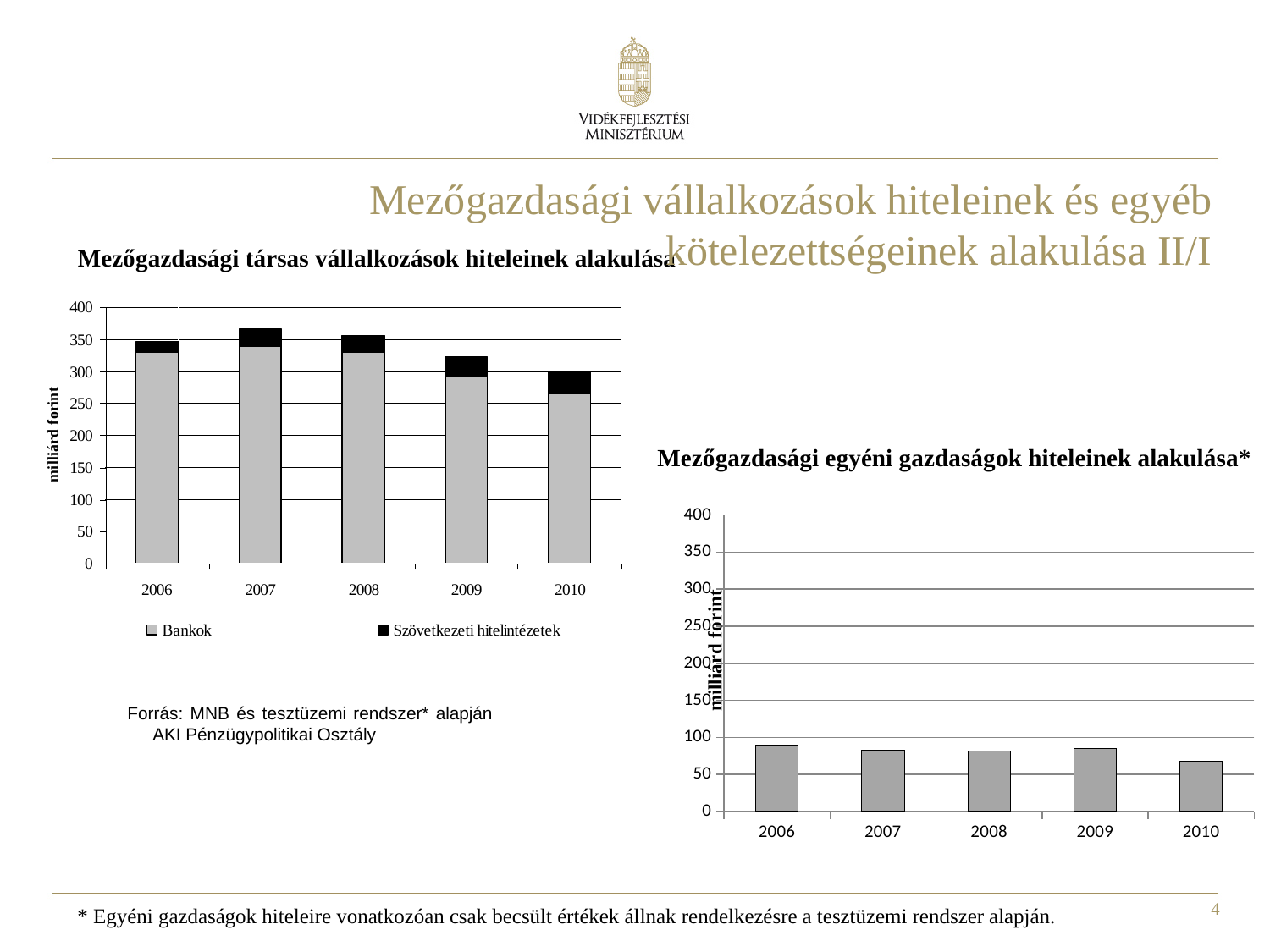
In the left chart, which year has the lowest total bar? 2010 How many series does the legend of the left chart list? 2 In the right chart, which year has the lowest bar? 2010 In the left chart, is the total for 2009 greater or less than 300? greater In the right chart, is the value for 2006 greater or less than 100? less What kind of chart is the right chart titled 'Mezőgazdasági egyéni gazdaságok hiteleinek alakulása*'? Bar chart What kind of chart is the left chart titled 'Mezőgazdasági társas vállalkozások hiteleinek alakulása'? Stacked bar chart In the left chart, is the total for 2007 greater or less than 350? greater In the left chart, do the total bars rise or fall from 2007 to 2010? fall How many years are shown on the x axis of the right chart? 5 What is the y-axis label of the left chart? milliárd forint